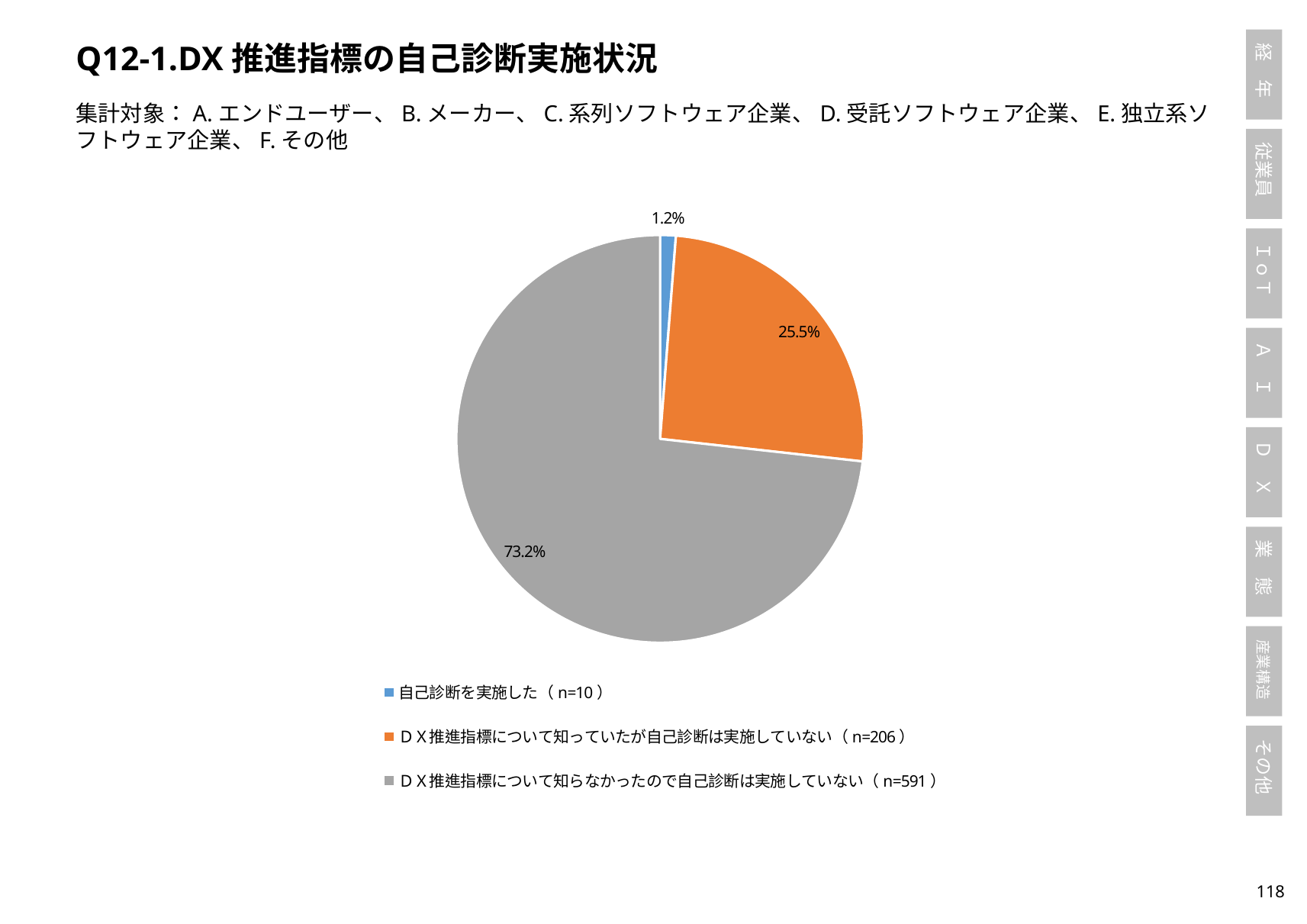
How many categories does the pie chart have? 3 Which category has the largest slice of the pie? ＤＸ推進指標について知らなかったので自己診断は実施していない（n=591） What is the title of the slide containing the chart? Q12-1.DX 推進指標の自己診断実施状況 What is the n value shown in the legend for 自己診断を実施した? n=10 Which category has the smallest slice of the pie? 自己診断を実施した（n=10） What share of the pie does ＤＸ推進指標について知らなかったので自己診断は実施していない (n=591) have? 73.2% What share of the pie does 自己診断を実施した (n=10) have? 1.2% What is the difference in percentage points between the 73.2% slice and the 25.5% slice? 47.7 Which is larger: the share for 自己診断を実施した or the share for ＤＸ推進指標について知っていたが自己診断は実施していない? ＤＸ推進指標について知っていたが自己診断は実施していない What colour is the slice for ＤＸ推進指標について知らなかったので自己診断は実施していない? gray What share of the pie does ＤＸ推進指標について知っていたが自己診断は実施していない (n=206) have? 25.5% What kind of chart is shown on the slide? pie chart